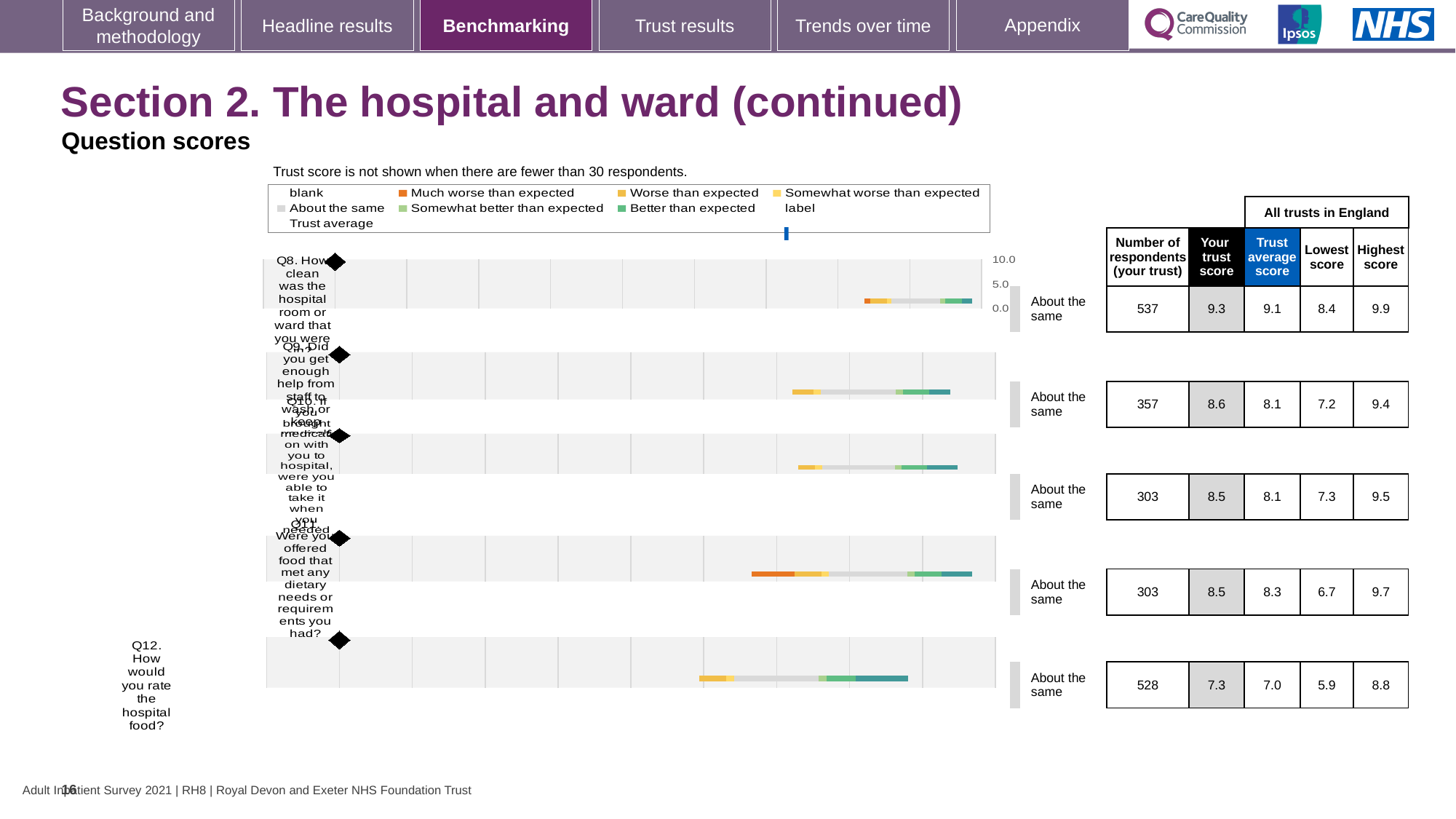
What kind of chart is used to show the question scores on this slide? bar chart How many respondents answered Q12 (how would you rate the hospital food)? 528 For Q8, what is the difference between 'Your trust score' and the 'Trust average score'? 0.2 Which question has the highest 'Your trust score'? Q8 What is the 'Your trust score' value for Q8 (how clean was the hospital room or ward)? 9.3 For Q11, what is the difference between the highest score and the lowest score across all trusts in England? 3.0 How many questions (Q8 to Q12) are plotted in the chart? 5 What is the 'Highest score' across all trusts in England for Q11? 9.7 What is the 'Lowest score' across all trusts in England for Q12? 5.9 For Q9, which is larger: 'Your trust score' or the 'Trust average score'? Your trust score Which question has the lowest 'Your trust score'? Q12 What benchmark category is shown next to every question in the chart? About the same